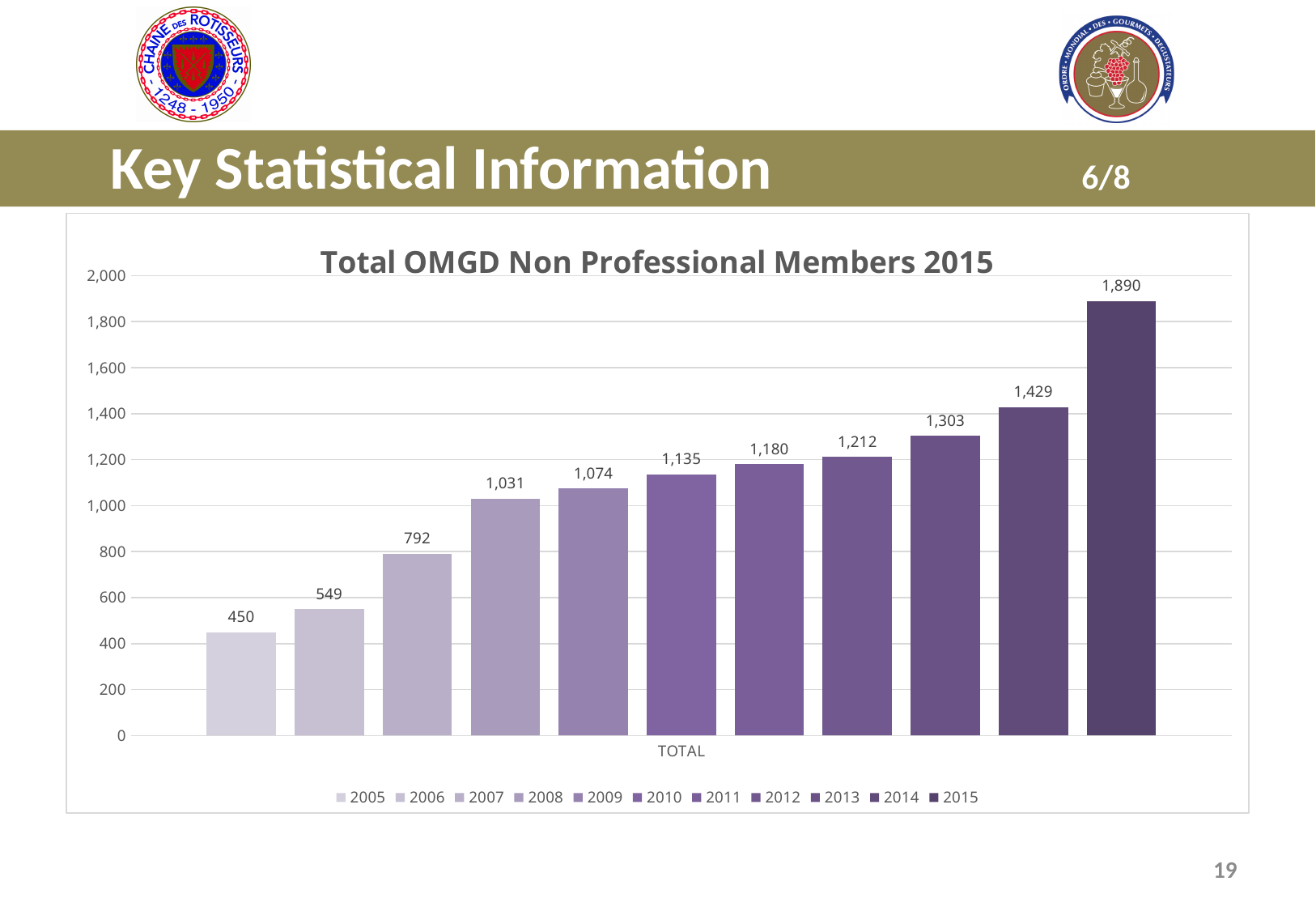
What kind of chart is shown? bar chart Do the values rise or fall from 2005 to 2015? rise What is the value for 2010? 1,135 Which year has the lowest value? 2005 Which year has the highest value? 2015 What is the value for 2015? 1,890 What is the difference between the values for 2015 and 2014? 461 How many series does the legend list? 11 What is the title of the chart? Total OMGD Non Professional Members 2015 Which is larger, the value for 2008 or the value for 2012? 2012 What is the value for 2005? 450 What is the difference between the values for 2007 and 2006? 243